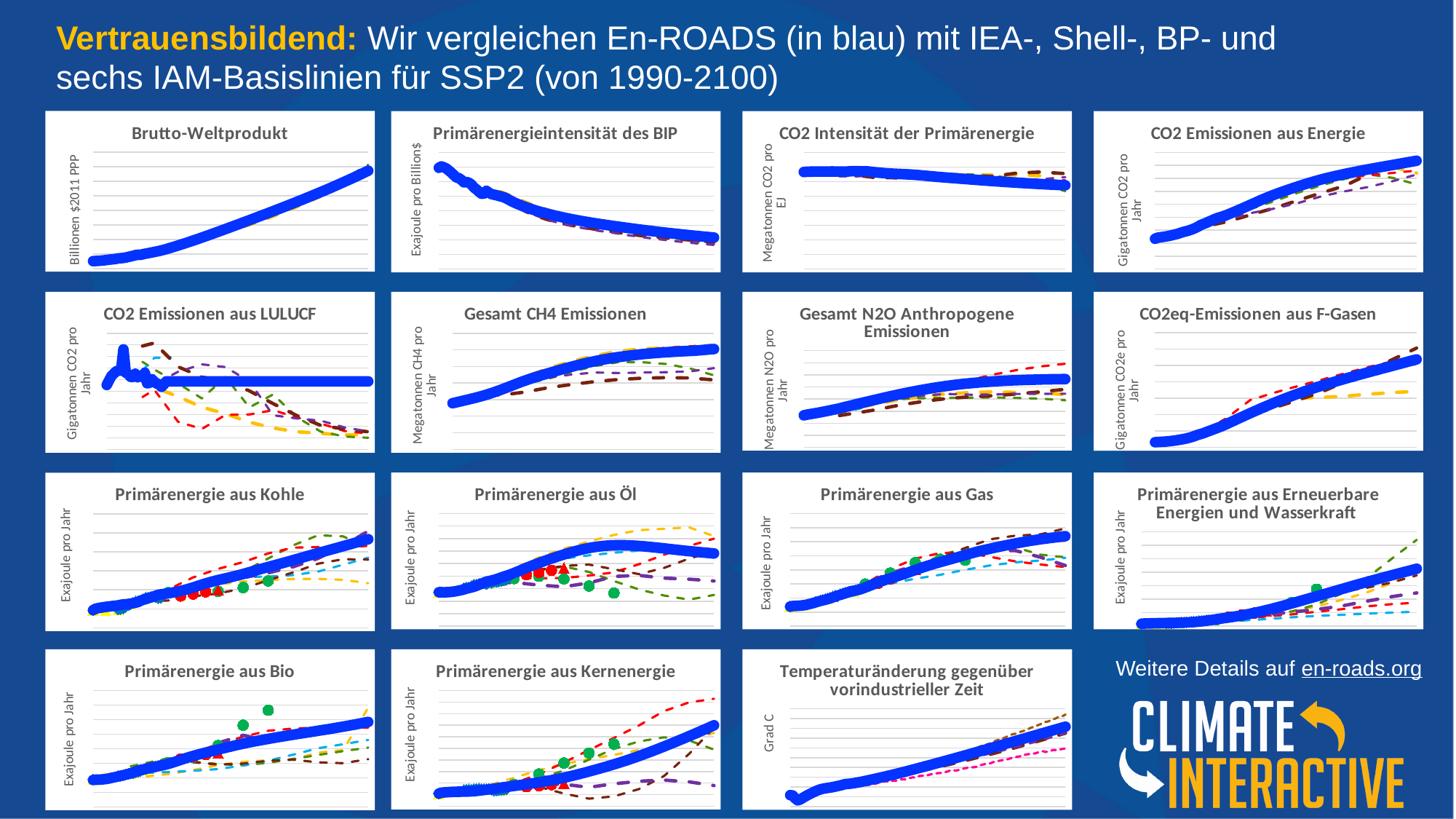
What is the y-axis label of the 'Brutto-Weltprodukt' chart? Billionen $2011 PPP In the 'Primärenergie aus Erneuerbare Energien und Wasserkraft' chart, does the blue En-ROADS line rise or fall from left to right? rise What is the y-axis label of the 'Temperaturänderung gegenüber vorindustrieller Zeit' chart? Grad C In the 'CO2 Emissionen aus Energie' chart, does the blue En-ROADS line rise or fall from left to right? rise In the 'Brutto-Weltprodukt' chart, does the blue En-ROADS line rise or fall from left to right? rise How many charts are shown on the slide? 15 What kind of chart is the 'Brutto-Weltprodukt' chart? line chart What kind of chart is the 'Primärenergie aus Kohle' chart? line chart